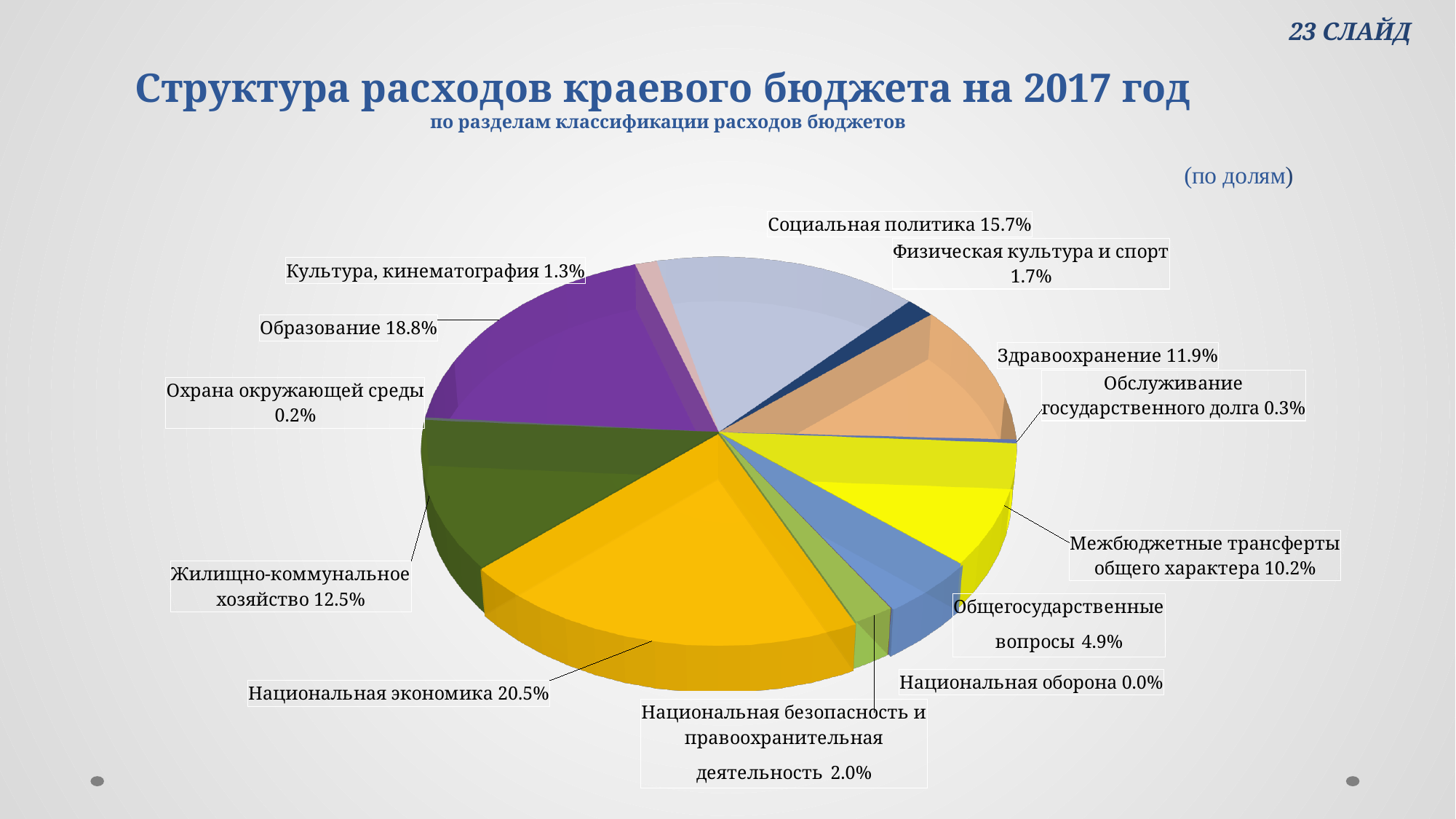
Which expenditure section has the smallest share of the pie? Национальная оборона What is the difference between the shares of Социальная политика and Жилищно-коммунальное хозяйство? 3.2% What kind of chart is shown on the slide? pie chart What is the combined share of Межбюджетные трансферты общего характера and Общегосударственные вопросы? 15.1% What is the title of the chart on the slide? Структура расходов краевого бюджета на 2017 год Which expenditure section has the largest share of the pie? Национальная экономика What is the value shown for Обслуживание государственного долга? 0.3% What share of the 2017 regional budget expenditure goes to Национальная экономика? 20.5% How many expenditure sections are shown in the pie chart? 13 What is the value shown for Образование? 18.8% What is the value shown for Здравоохранение? 11.9% Which is larger: the share for Образование or the share for Социальная политика? Образование